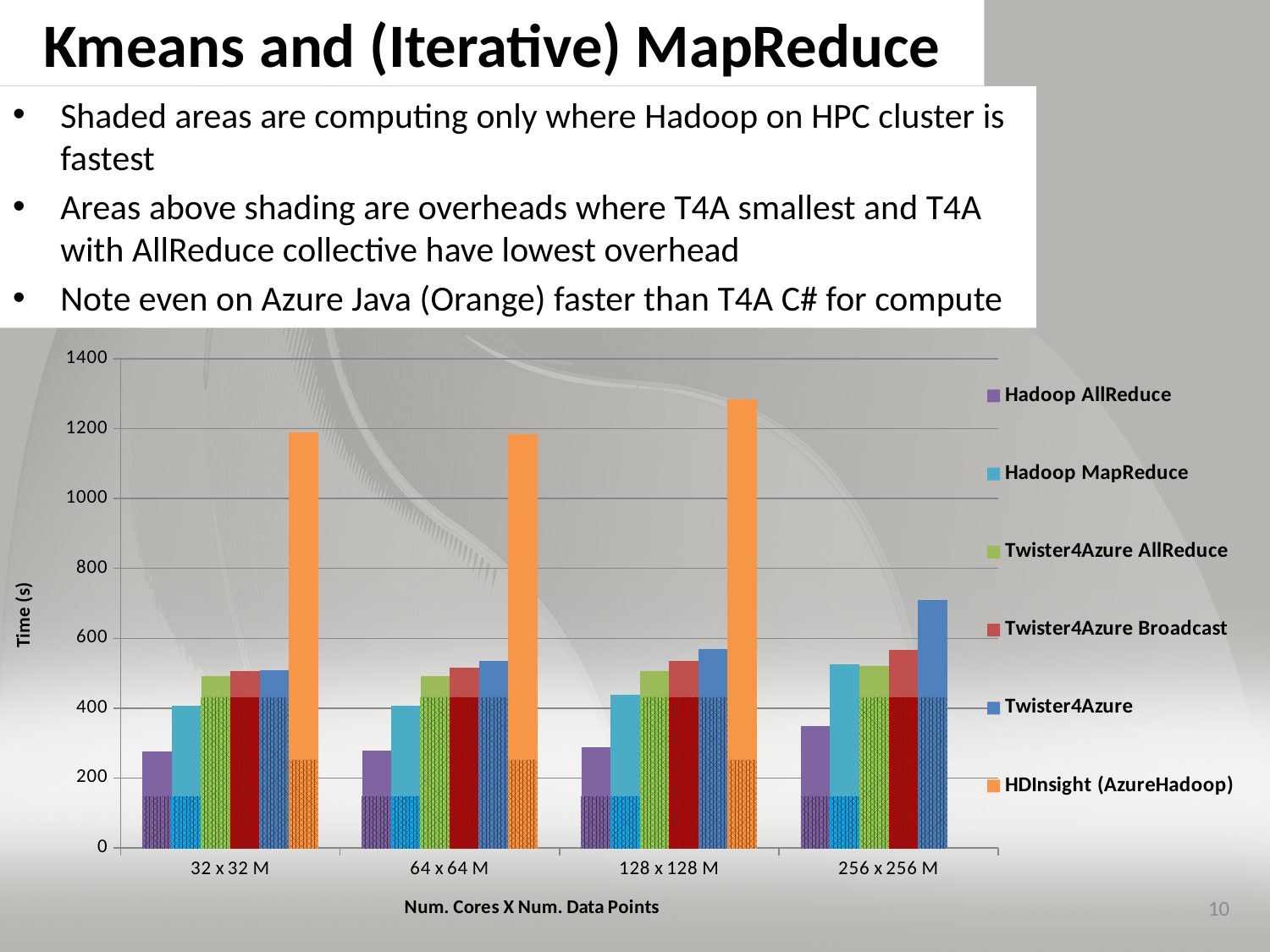
How many series does the chart legend list? 6 Which series has the highest value for the 32 x 32 M category? HDInsight (AzureHadoop) What kind of chart is shown on the slide? bar chart Do the values for Twister4Azure rise or fall as the categories move from 32 x 32 M to 256 x 256 M? rise How many categories are shown on the x axis of the chart? 4 Which series has the highest value for the 256 x 256 M category? Twister4Azure Is the value for Hadoop AllReduce at 32 x 32 M greater or less than 400? less What is the label of the y axis of the chart? Time (s) Which series has the lowest value for the 128 x 128 M category? Hadoop AllReduce Is the value for Twister4Azure at 256 x 256 M greater or less than 600? greater Which is larger at 64 x 64 M: the value for Hadoop MapReduce or the value for Twister4Azure Broadcast? Twister4Azure Broadcast Is the value for HDInsight (AzureHadoop) at 32 x 32 M greater or less than 1000? greater